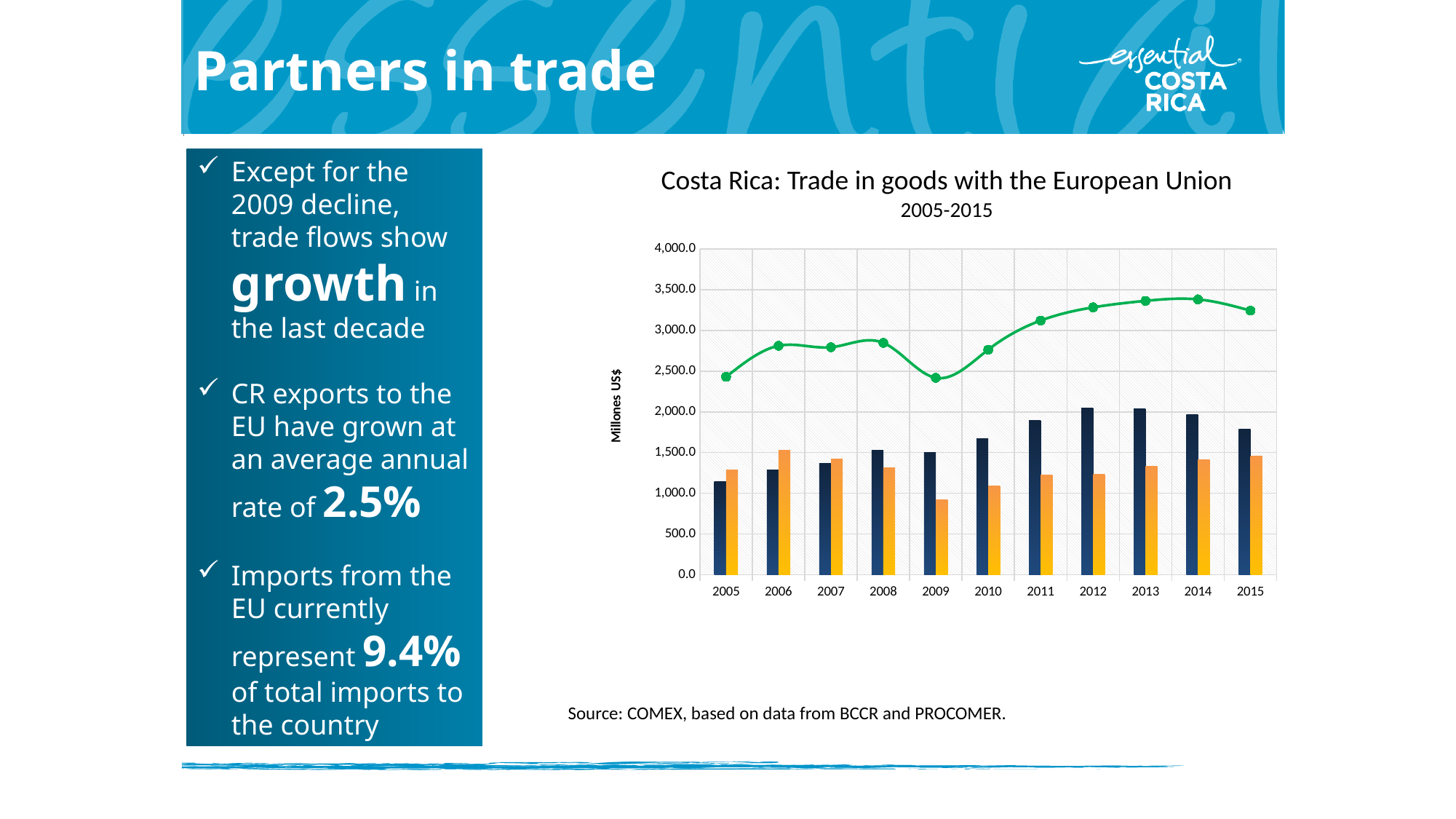
In which year is the orange bar the lowest? 2009 In which year is the dark blue bar the lowest? 2005 Is the value of the green line for 2009 greater or less than 2,500? less Is the orange bar for 2009 greater or less than 1,000? less What kind of chart is shown on the slide? A combined bar and line chart Is the value of the green line for 2014 greater or less than 3,000? greater In 2010, which is larger, the dark blue bar or the orange bar? The dark blue bar What is the title of the chart? Costa Rica: Trade in goods with the European Union 2005-2015 What is the label on the vertical axis of the chart? Millones US$ Does the green line rise or fall from 2009 to 2014? Rises How many years are shown on the x axis of the chart? 11